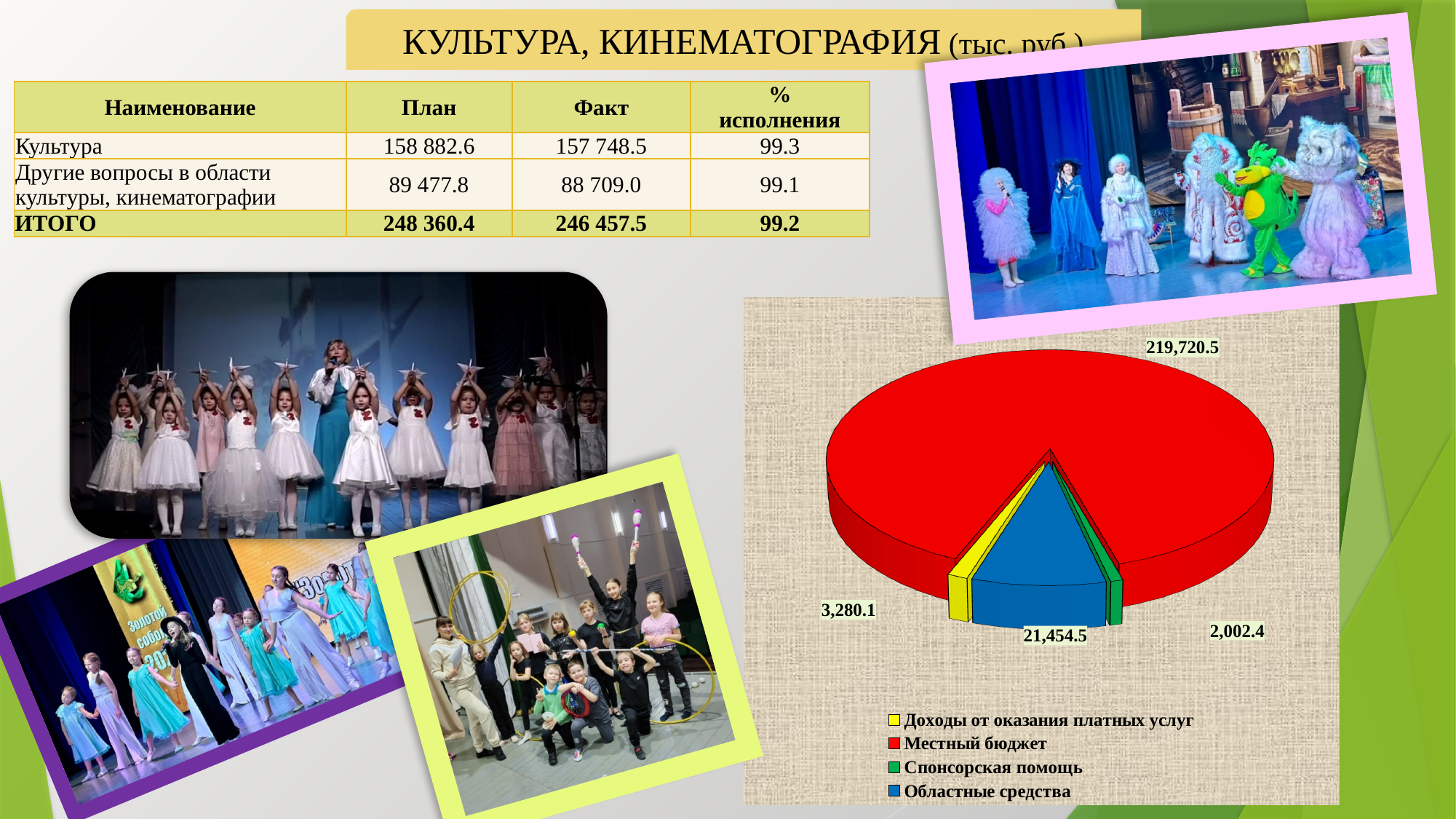
What is the value for Областные средства in the pie chart? 21,454.5 What is the difference between Доходы от оказания платных услуг and Спонсорская помощь in the pie chart? 1,277.7 Which category has the smallest slice in the pie chart? Спонсорская помощь How many slices does the pie chart have? 4 Which is larger in the pie chart: Областные средства or Доходы от оказания платных услуг? Областные средства What type of chart is shown on the slide? pie chart What is the value for Местный бюджет in the pie chart? 219,720.5 Which category has the largest slice in the pie chart? Местный бюджет What colour represents Областные средства in the pie chart legend? blue What is the difference between Областные средства and Доходы от оказания платных услуг in the pie chart? 18,174.4 What is the value for Доходы от оказания платных услуг in the pie chart? 3,280.1 What is the value for Спонсорская помощь in the pie chart? 2,002.4